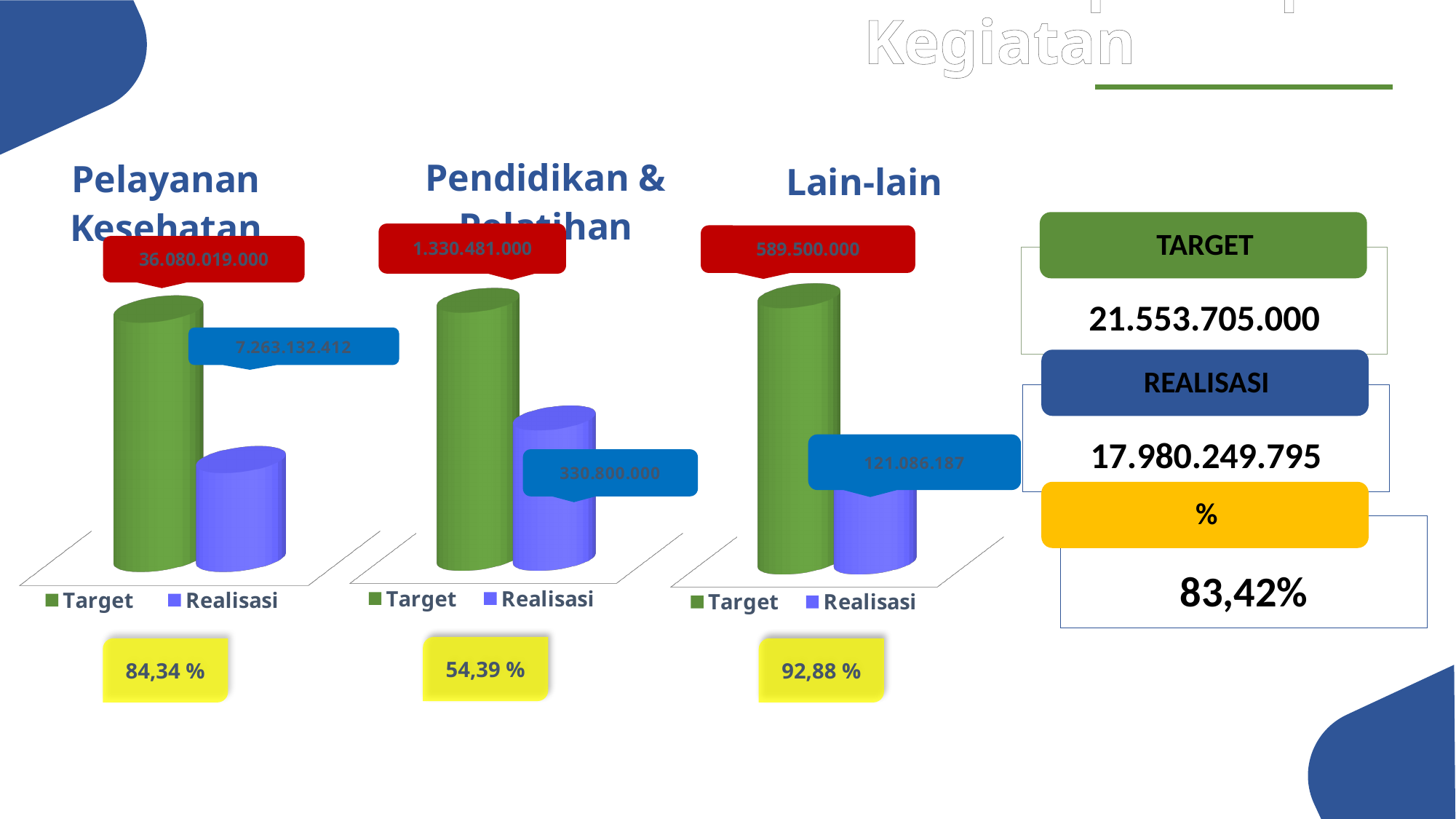
In the Lain-lain chart, what is the value of Target? 589.500.000 What kind of chart is used for Pelayanan Kesehatan? Bar chart In the Pendidikan & Pelatihan chart, what is the value of Target? 1.330.481.000 How many series does the legend of the Pendidikan & Pelatihan chart list? 2 In the Pelayanan Kesehatan chart, what is the value of Realisasi? 7.263.132.412 In the Pelayanan Kesehatan chart, which is larger, Target or Realisasi? Target In the Lain-lain chart, what is the difference between Target and Realisasi? 468.413.813 How many bar charts are shown on the slide? 3 In the Lain-lain chart, which series is shown in green? Target In the Pendidikan & Pelatihan chart, what is the value of Realisasi? 330.800.000 In the Lain-lain chart, what is the value of Realisasi? 121.086.187 In the Pendidikan & Pelatihan chart, what is the difference between Target and Realisasi? 999.681.000